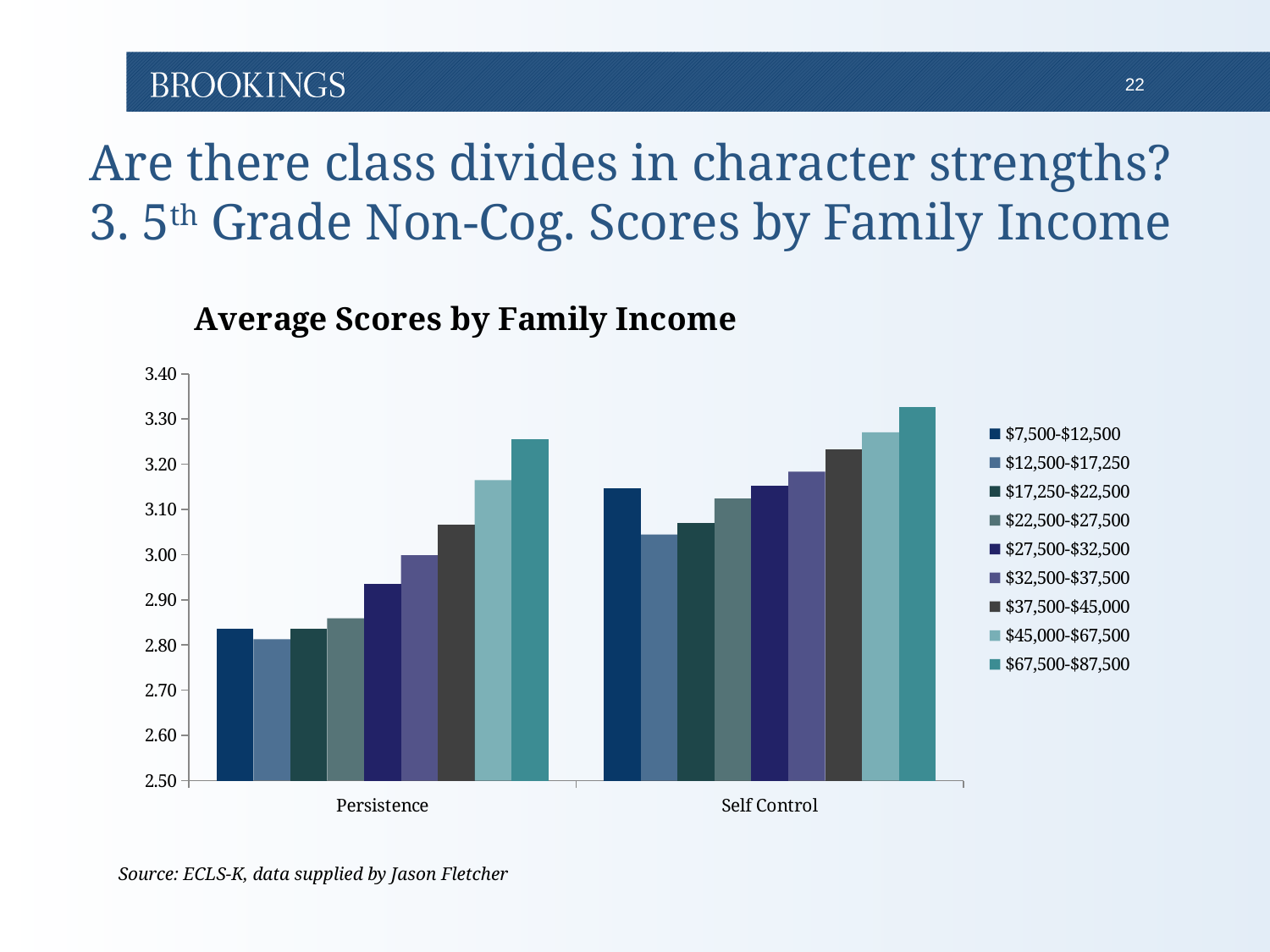
Is the Persistence score for the $67,500-$87,500 group greater or less than 3.20? greater Is the Persistence score for the $27,500-$32,500 group greater or less than 3.00? less What is the title of the chart? Average Scores by Family Income For the $7,500-$12,500 group, which is higher: the Persistence score or the Self Control score? Self Control Which family income group has the lowest Self Control score? $12,500-$17,250 What kind of chart is shown on the slide? bar chart Which family income group has the highest Persistence score? $67,500-$87,500 Which family income group has the highest Self Control score? $67,500-$87,500 How many categories are shown on the x axis? 2 How many family income groups does the legend list? 9 Which family income group has the lowest Persistence score? $12,500-$17,250 Is the Self Control score for the $12,500-$17,250 group greater or less than 3.10? less